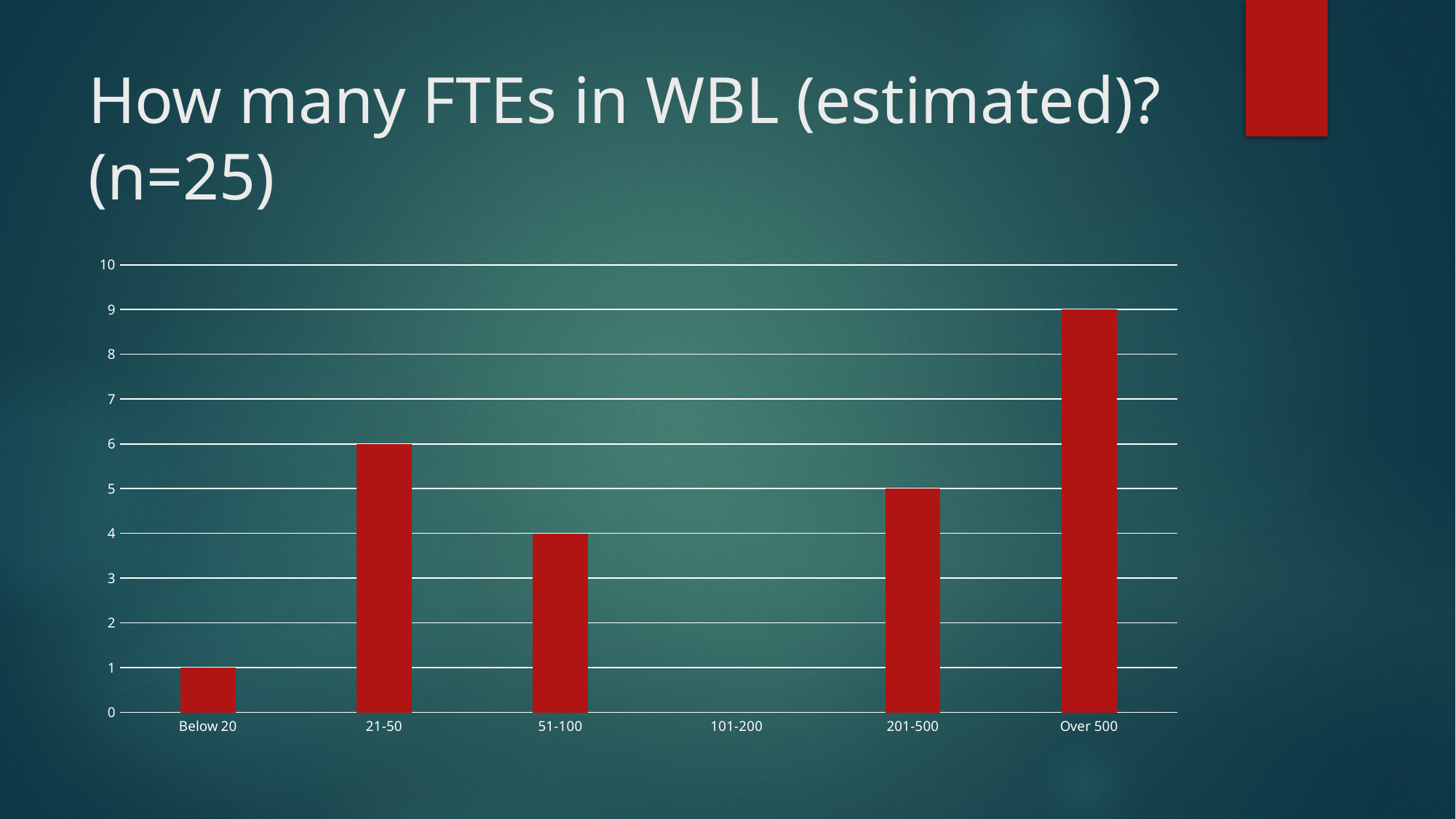
What is the value for the 21-50 category? 6 What kind of chart is shown on the slide? Bar chart How many categories are shown on the x axis? 6 Which category has the highest value? Over 500 What is the title of the slide containing the chart? How many FTEs in WBL (estimated)? (n=25) What is the difference between the values for Over 500 and 21-50? 3 Is the value for 21-50 greater or less than 5? greater What is the value for the Below 20 category? 1 Which category has the lowest value? 101-200 What is the value for the Over 500 category? 9 Which is larger, the value for 51-100 or the value for 201-500? 201-500 What is the value for the 201-500 category? 5